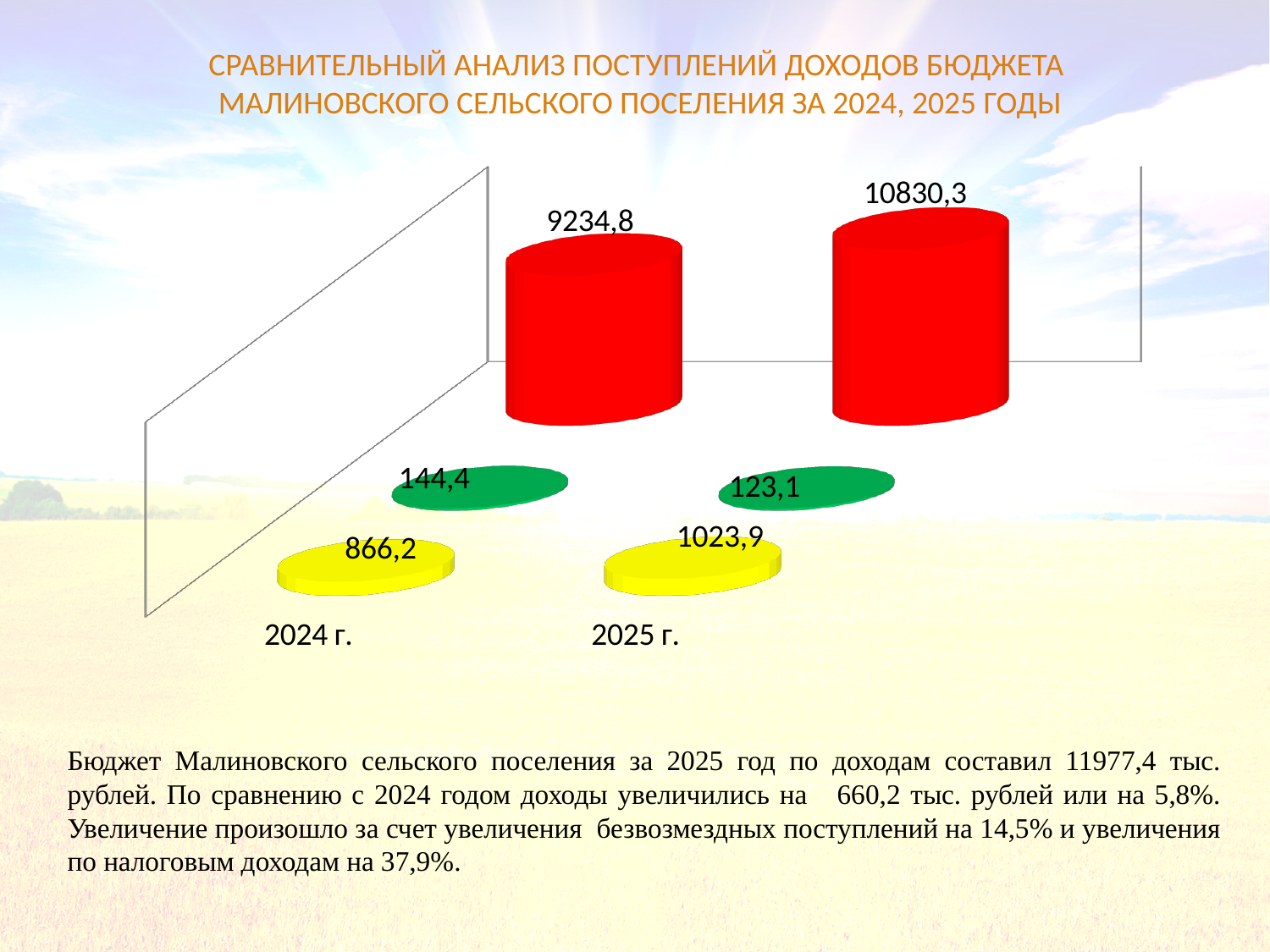
What is the value of the yellow series for 2024 г.? 866,2 Is the yellow series value for 2024 г. larger or smaller than the yellow series value for 2025 г.? smaller What is the difference between the yellow series values for 2025 г. and 2024 г.? 157,7 By how much does the red series value for 2025 г. exceed that for 2024 г.? 1595,5 Which year has the higher value for the red series? 2025 г. What is the value of the green series for 2024 г.? 144,4 What is the value of the red series for 2025 г.? 10830,3 Which year has the lower value for the green series? 2025 г. How many years (categories) are shown on the chart? 2 What is the value of the red series for 2024 г.? 9234,8 What is the value of the yellow series for 2025 г.? 1023,9 What is the value of the green series for 2025 г.? 123,1